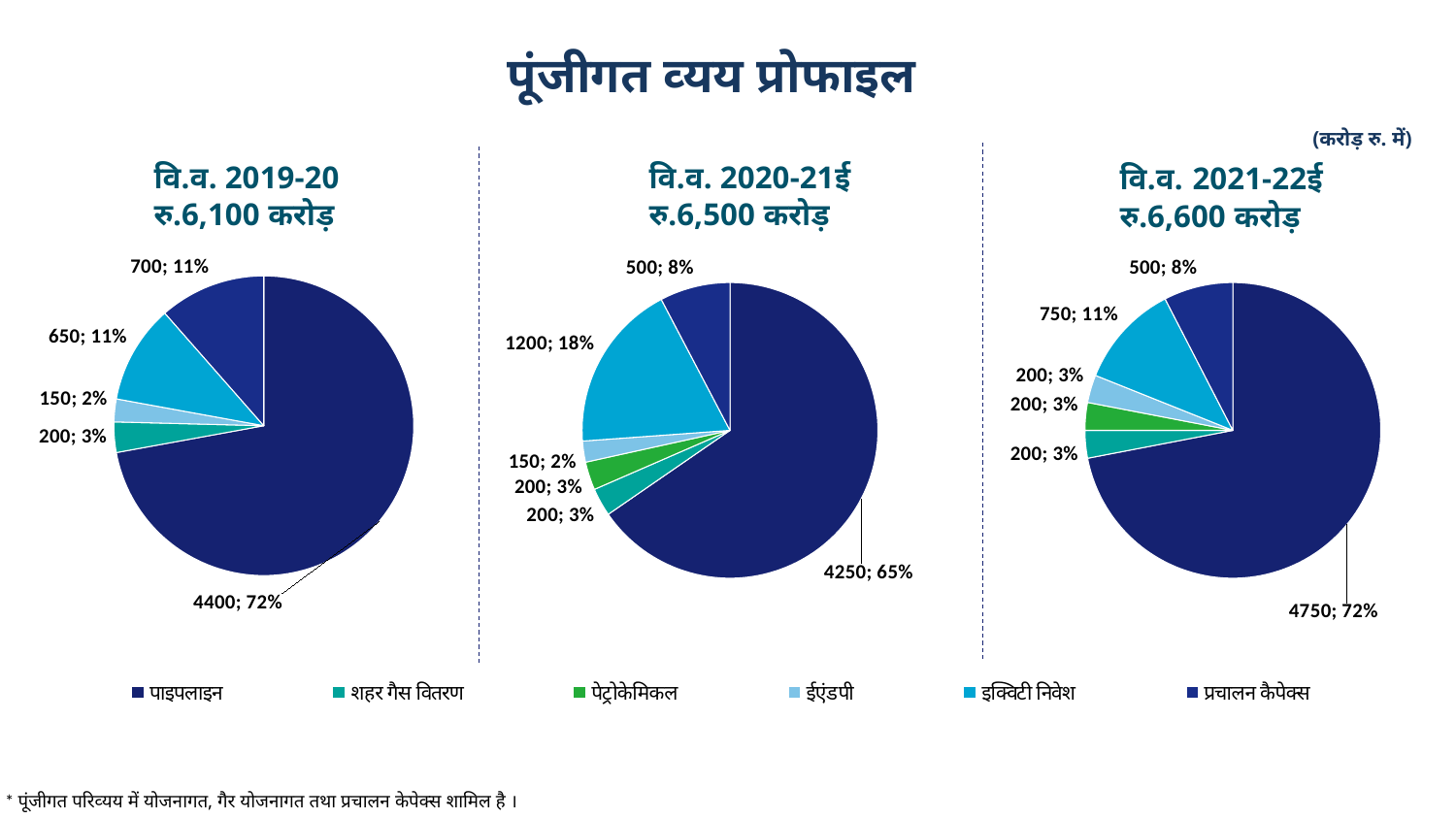
What is the difference between the पाइपलाइन value in the वि.व. 2021-22ई chart and the पाइपलाइन value in the वि.व. 2020-21ई chart? 500 In the वि.व. 2020-21ई pie chart, what is the value of the इक्विटी निवेश slice? 1200 What kind of charts are shown on the slide? Pie charts How many pie charts are on the slide? 3 In the वि.व. 2021-22ई pie chart, what share of the pie does the पाइपलाइन slice represent? 72% What total is shown under the heading of the वि.व. 2020-21ई pie chart? रु.6,500 करोड़ What is the title of the slide? पूंजीगत व्यय प्रोफाइल Which is larger: the इक्विटी निवेश slice in the वि.व. 2020-21ई chart or the इक्विटी निवेश slice in the वि.व. 2021-22ई chart? वि.व. 2020-21ई (1200) In the वि.व. 2019-20 pie chart, which slice is the smallest? ईएंडपी (150; 2%) In the वि.व. 2019-20 pie chart, what is the value and share of the largest slice (पाइपलाइन)? 4400; 72% In the वि.व. 2020-21ई pie chart, what share does the पाइपलाइन slice represent? 65% How many series does the legend list? 6